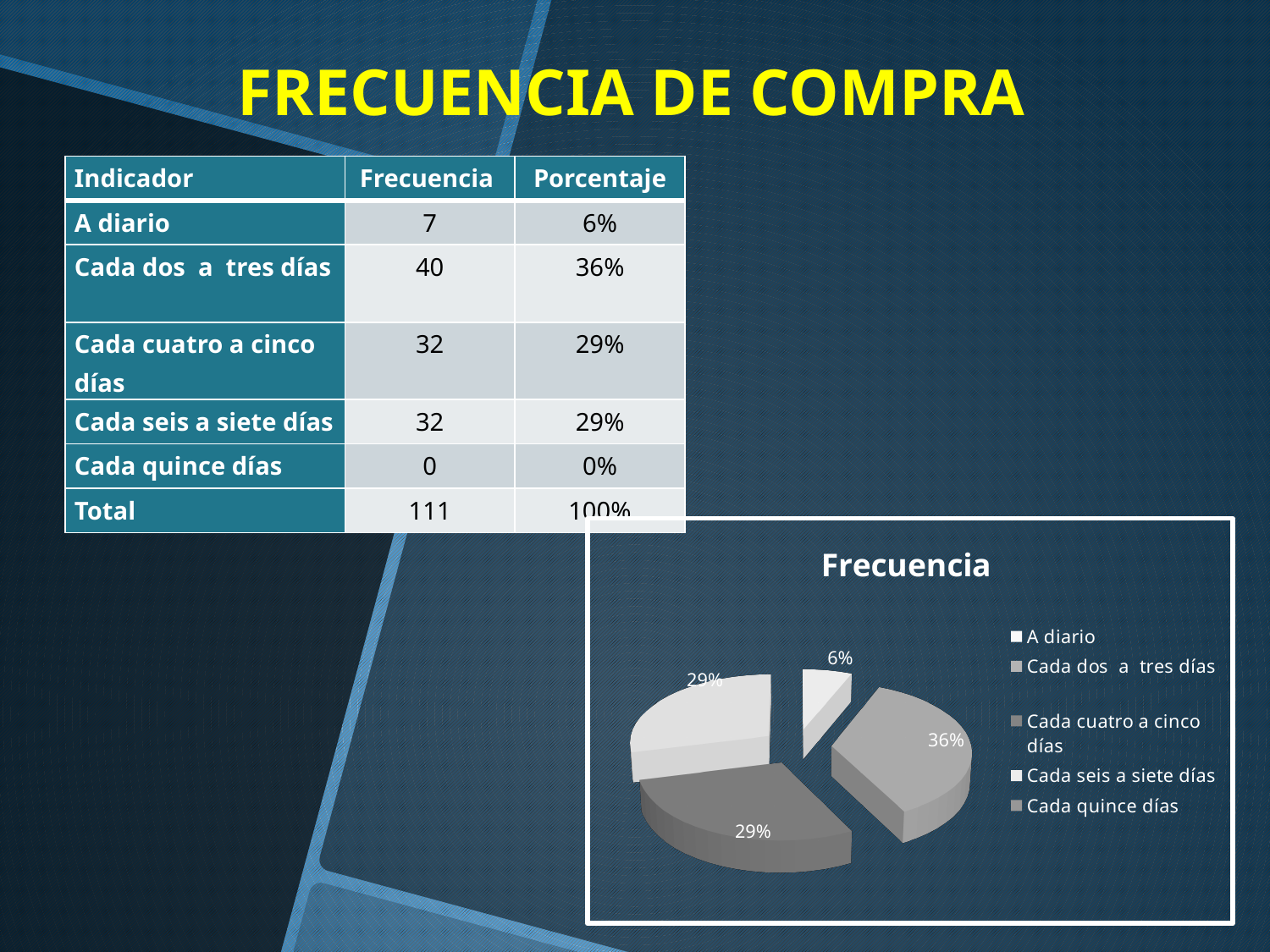
How many entries does the chart legend list? 5 What is the difference in percentage points between the 'Cada dos a tres días' slice and the 'A diario' slice? 30 Which category has the largest slice of the pie? Cada dos a tres días What kind of chart is shown on the slide? pie chart What share of the pie does 'Cada seis a siete días' represent? 29% Which category has the smallest visible slice of the pie? A diario What share of the pie does 'A diario' represent? 6% How many percentage labels are printed on the pie chart? 4 What share of the pie does 'Cada dos a tres días' represent? 36% Which slice is larger, 'Cada dos a tres días' or 'Cada cuatro a cinco días'? Cada dos a tres días What is the title of the chart? Frecuencia